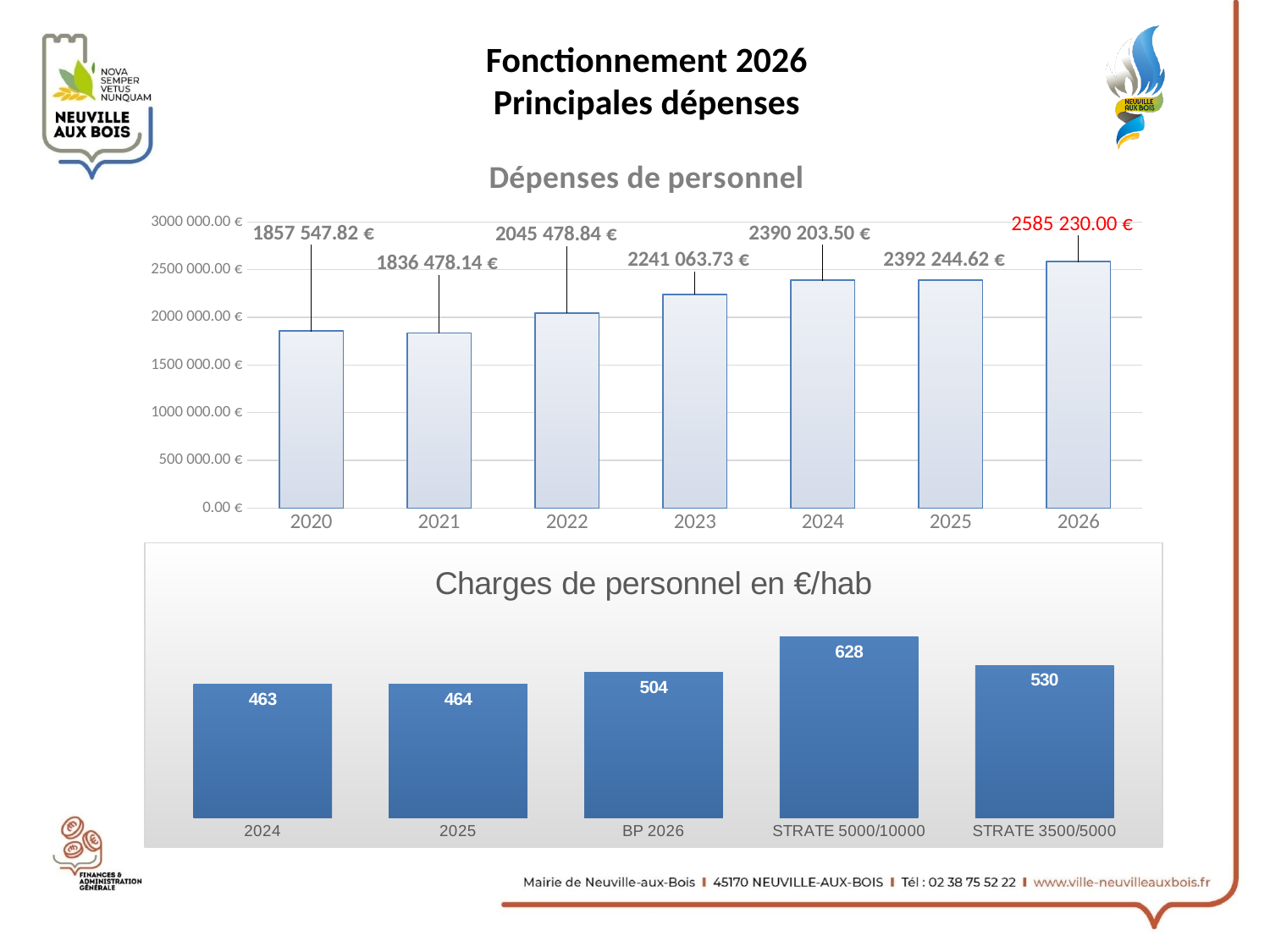
In the 'Dépenses de personnel' chart, what is the difference between the 2026 and 2025 values? 192 985.38 € In the 'Charges de personnel en €/hab' chart, which is larger, STRATE 3500/5000 or BP 2026? STRATE 3500/5000 In the 'Charges de personnel en €/hab' chart, which category has the highest value? STRATE 5000/10000 In the 'Dépenses de personnel' chart, which year has the highest value? 2026 In the 'Dépenses de personnel' chart, what is the value for 2021? 1836 478.14 € In the 'Dépenses de personnel' chart, what is the value for 2026? 2585 230.00 € In the 'Charges de personnel en €/hab' chart, what is the value for BP 2026? 504 In the 'Charges de personnel en €/hab' chart, what is the difference between STRATE 5000/10000 and BP 2026? 124 What type of chart is the 'Charges de personnel en €/hab' chart? bar chart In the 'Dépenses de personnel' chart, which year has the lowest value? 2021 In the 'Dépenses de personnel' chart, how many years are shown? 7 In the 'Dépenses de personnel' chart, is the value for 2023 greater or less than 2000 000.00 €? greater